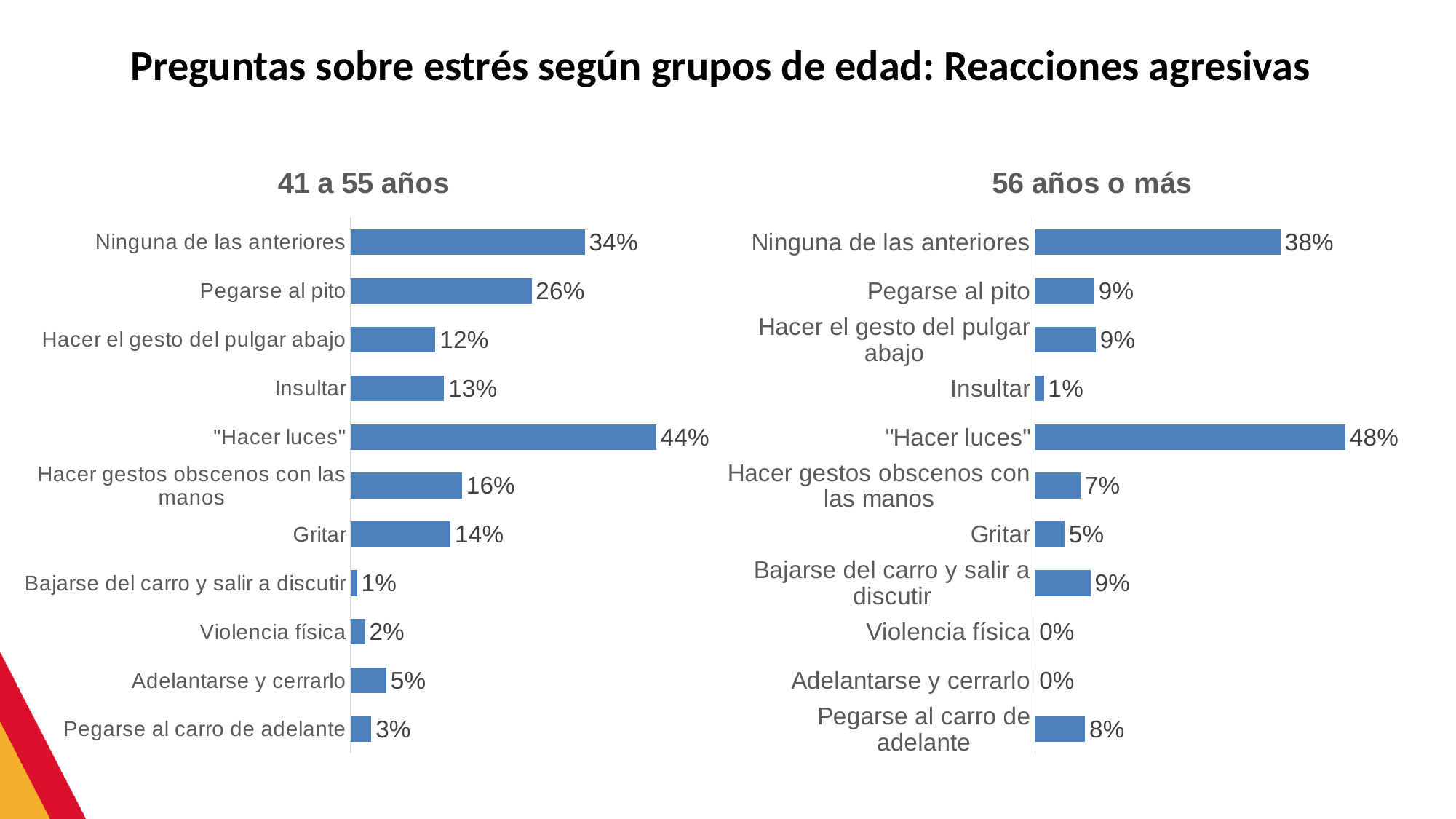
In the "41 a 55 años" chart, which is larger: "Gritar" or "Insultar"? Gritar In the "41 a 55 años" chart, which category has the highest value? "Hacer luces" In the "56 años o más" chart, what is the value for "Violencia física"? 0% In the "41 a 55 años" chart, what is the value for "Pegarse al pito"? 26% In the "41 a 55 años" chart, what is the difference between "Hacer luces" and "Ninguna de las anteriores"? 10% In the "56 años o más" chart, what is the value for "Hacer luces"? 48% In the "56 años o más" chart, which category has the highest value? "Hacer luces" In the "56 años o más" chart, what is the difference between "Ninguna de las anteriores" and "Pegarse al pito"? 29% In the "41 a 55 años" chart, which category has the lowest value? Bajarse del carro y salir a discutir In the "56 años o más" chart, which is larger: "Pegarse al carro de adelante" or "Gritar"? Pegarse al carro de adelante What kind of chart is the "56 años o más" chart? Bar chart How many categories does the "41 a 55 años" chart show? 11